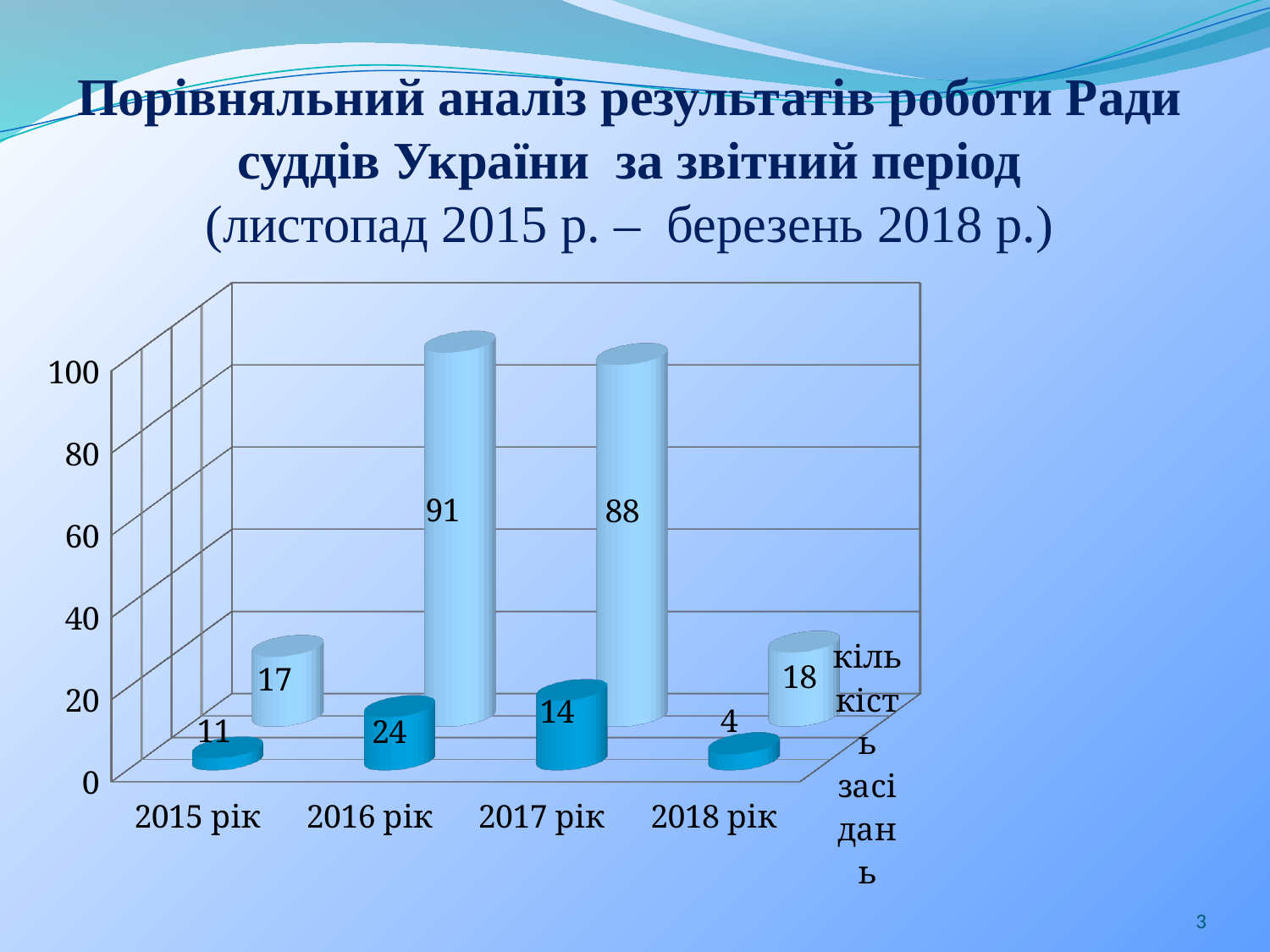
What is the value of the light blue (back) bar for 2017 рік? 88 What is the highest value shown on the vertical axis of the chart? 100 What is the difference between the light blue (back) bar and the dark blue (front) bar for 2015 рік? 6 What type of chart is shown on the slide? bar chart How many year categories are shown on the x axis of the chart? 4 What is the value of the dark blue (front) bar for 2016 рік? 24 Which year has the lowest value in the dark blue (front) series? 2018 рік What is the difference between the light blue (back) bar values for 2016 рік and 2017 рік? 3 Which is larger: the dark blue (front) bar for 2015 рік or the dark blue (front) bar for 2016 рік? 2016 рік Which year has the highest value in the light blue (back) series? 2016 рік What is the value of the light blue (back) bar for 2016 рік? 91 What is the value of the dark blue (front) bar for 2018 рік? 4